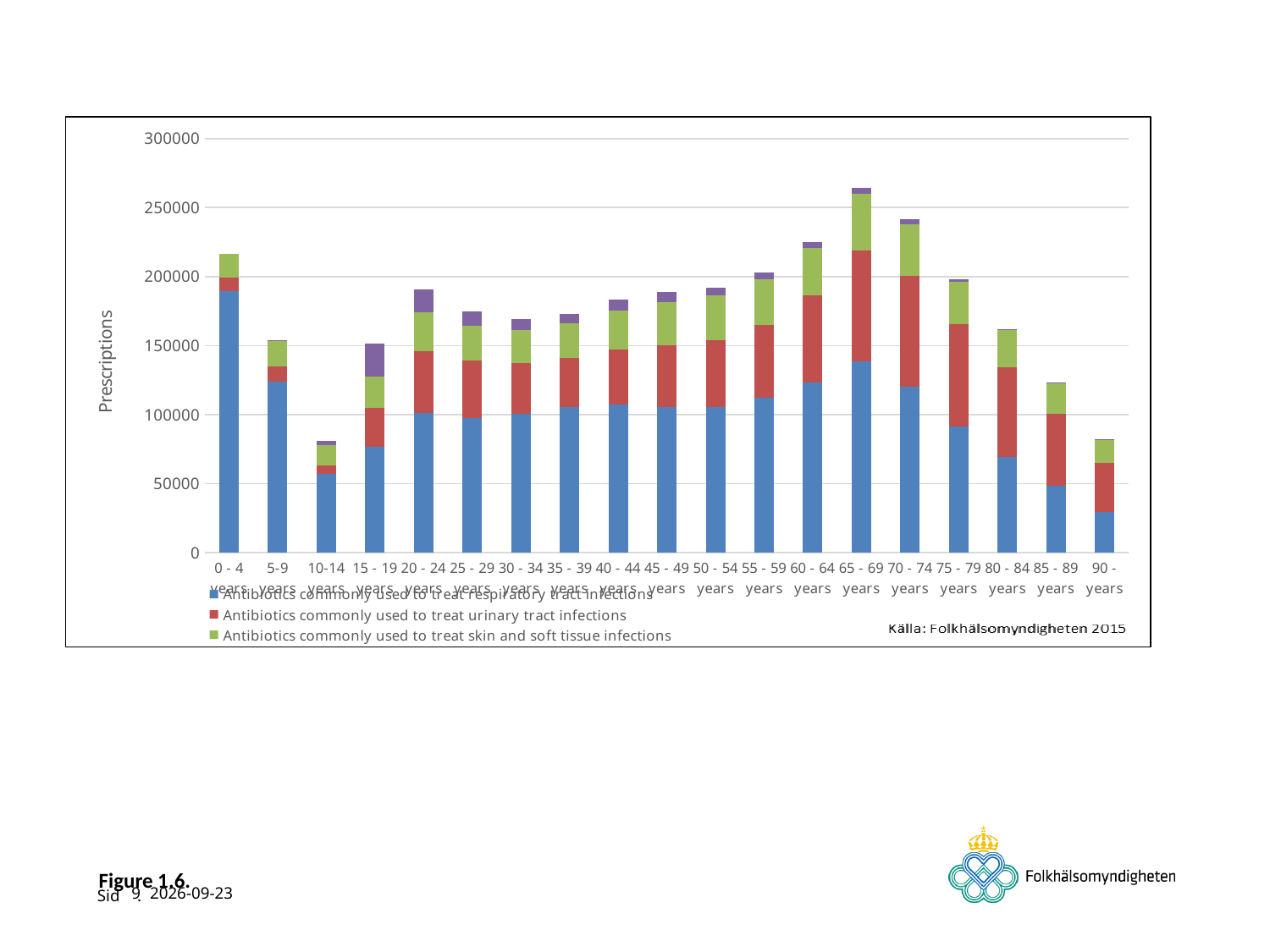
Is the total number of prescriptions for the 10-14 years group greater or less than 100000? less What kind of chart is shown on the slide? Stacked bar chart Which age group has the highest total number of prescriptions? 65 - 69 years Do the total prescriptions rise or fall from the 65 - 69 years group to the 90 - years group? fall Which has the larger total number of prescriptions, the 60 - 64 years group or the 80 - 84 years group? 60 - 64 years What is the label on the y axis? Prescriptions Which has the larger total number of prescriptions, the 0 - 4 years group or the 5-9 years group? 0 - 4 years Is the total number of prescriptions for the 0 - 4 years group greater or less than 200000? greater How many age-group categories are shown on the x axis? 19 How many series does the legend list? 3 Is the value for antibiotics commonly used to treat respiratory tract infections in the 0 - 4 years group greater or less than 150000? greater